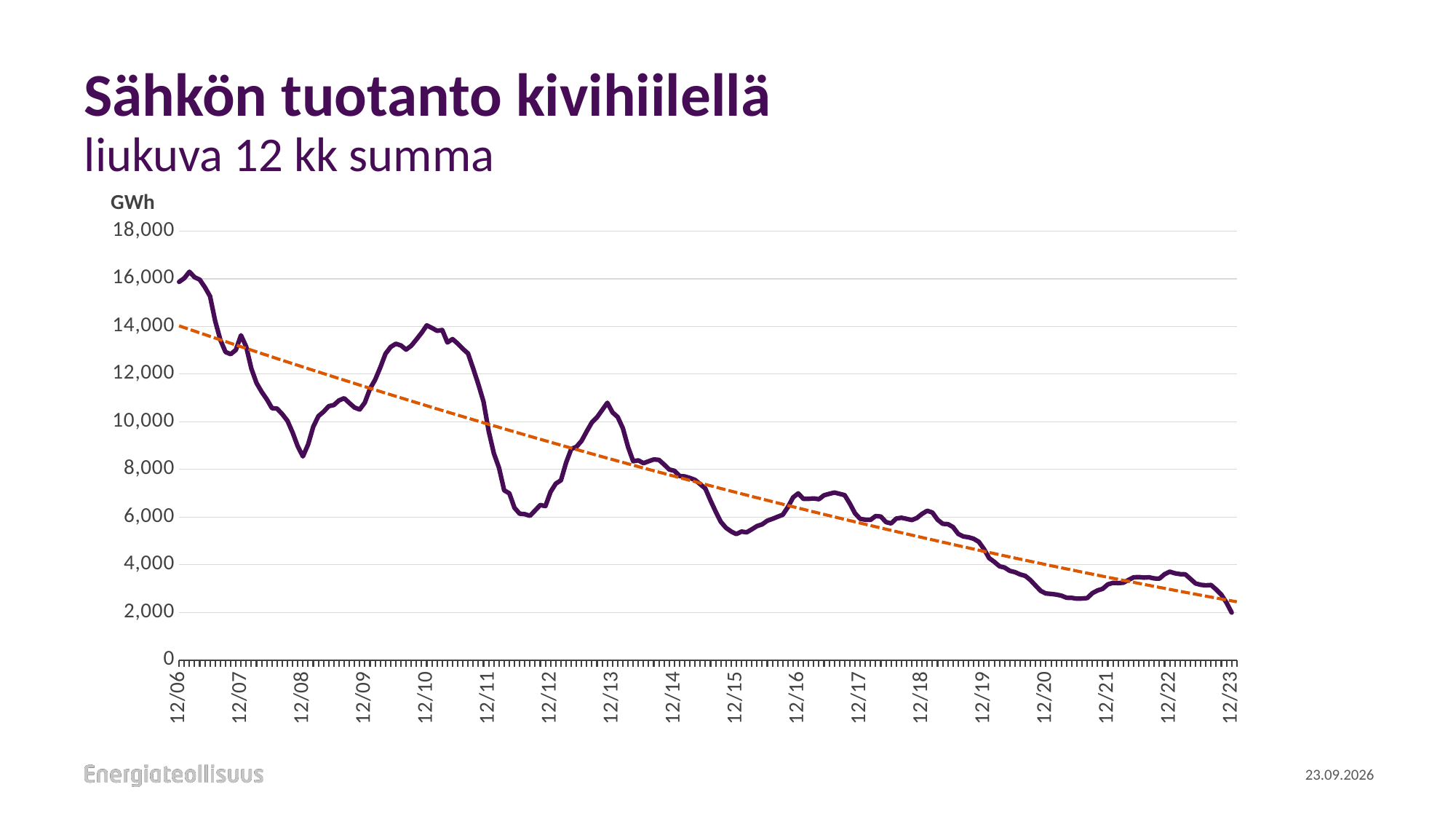
Which is larger, the value at 12/10 or the value at 12/11? 12/10 How many labelled points are there on the x axis? 18 What is the title of the chart on the slide? Sähkön tuotanto kivihiilellä Overall, do the values rise or fall from 12/06 to 12/23? fall Which is larger, the value at 12/06 or the value at 12/23? 12/06 What kind of chart is shown on the slide? line chart Is the value at 12/15 greater or less than 6,000? less Is the value at 12/06 greater or less than 14,000? greater Is the value at 12/08 greater or less than 10,000? less What unit is shown on the y axis of the chart? GWh